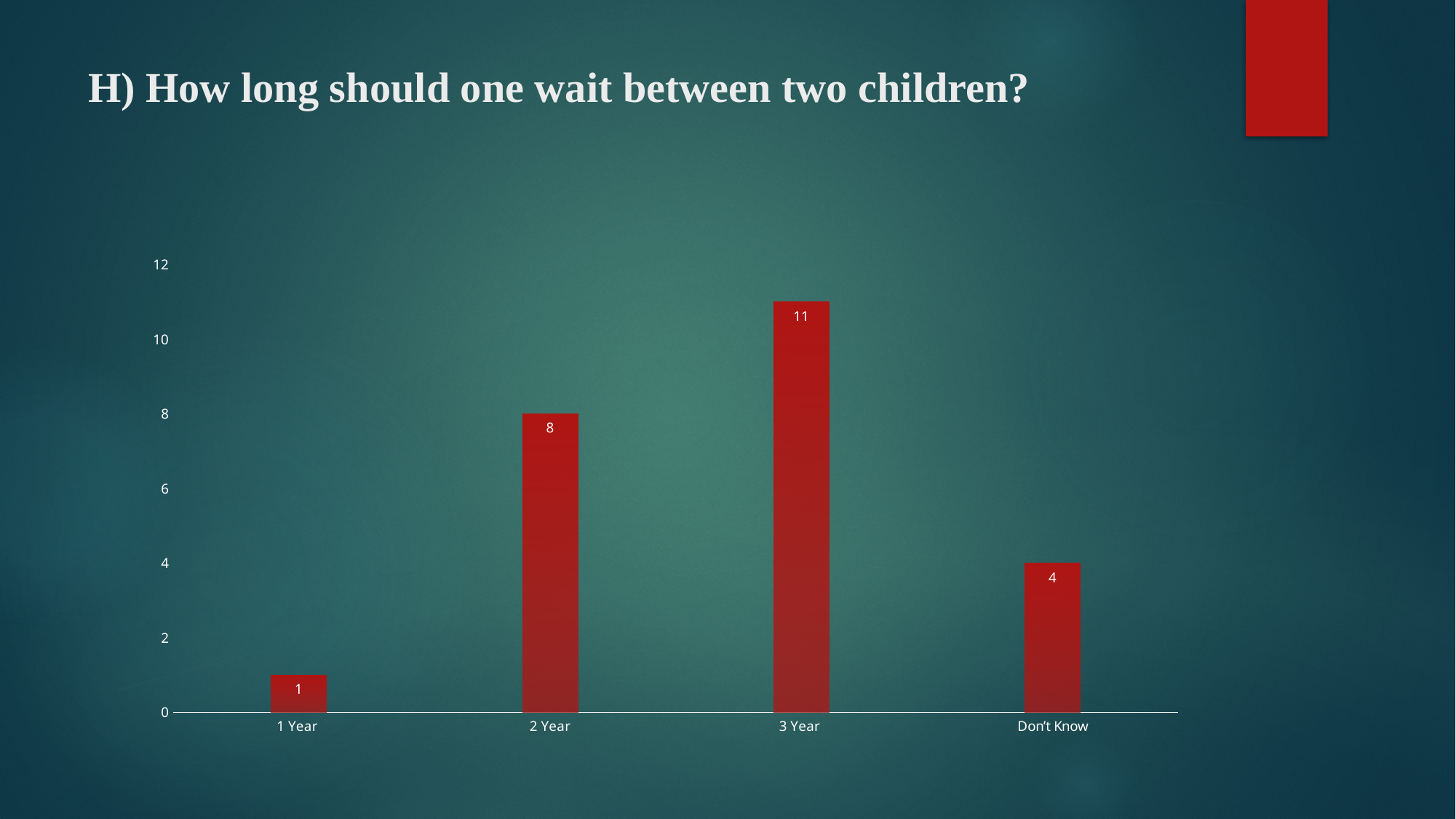
What is the value for 1 Year? 1 Which category has the lowest value? 1 Year What is the value for 2 Year? 8 What is the value for 3 Year? 11 Which is larger, the value for 2 Year or the value for Don't Know? 2 Year Is the value for 3 Year greater or less than 10? greater Which category has the highest value? 3 Year What kind of chart is shown on the slide? bar chart What is the difference between the values for 3 Year and 2 Year? 3 What is the value for Don't Know? 4 What is the title of the slide? H) How long should one wait between two children? How many categories are shown on the x axis? 4